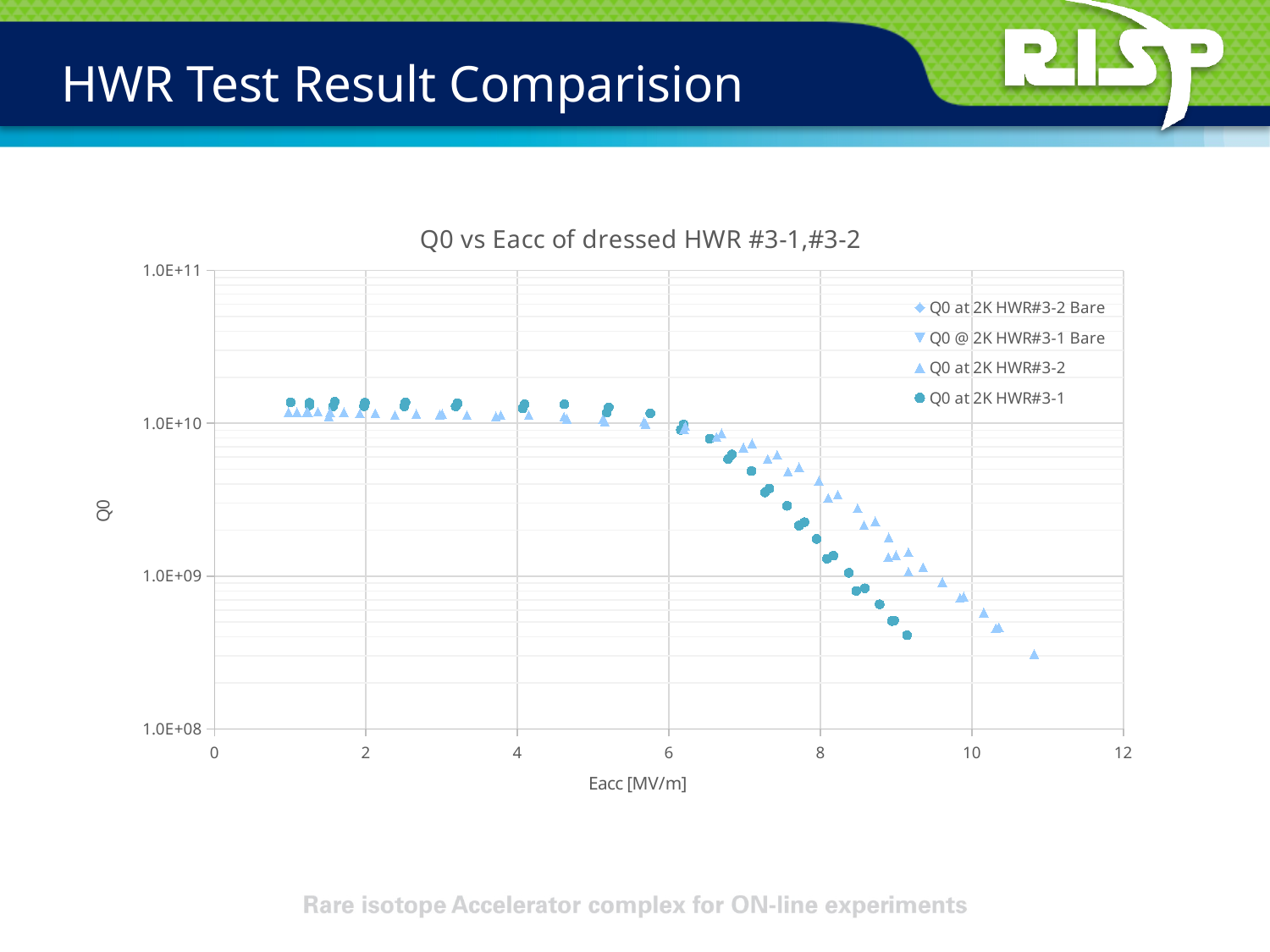
What is the highest value shown on the y axis? 1.0E+11 Is the Q0 value for the Q0 at 2K HWR#3-1 series at Eacc of about 2 MV/m greater or less than 1.0E+10? greater Is the Q0 value for the Q0 at 2K HWR#3-2 series at Eacc of about 8 MV/m greater or less than 1.0E+09? greater Which series reaches the highest Eacc value on the chart? Q0 at 2K HWR#3-2 How many series does the legend list? 4 At Eacc of about 9 MV/m, which series has the higher Q0: Q0 at 2K HWR#3-2 or Q0 at 2K HWR#3-1? Q0 at 2K HWR#3-2 What is the label of the x axis? Eacc [MV/m] What is the highest value shown on the x axis? 12 What is the title of the chart? Q0 vs Eacc of dressed HWR #3-1,#3-2 What kind of chart is shown on the slide? scatter chart As Eacc increases beyond about 6 MV/m, does Q0 rise or fall? fall Is the Q0 value for the Q0 at 2K HWR#3-1 series at Eacc of about 9 MV/m greater or less than 1.0E+09? less